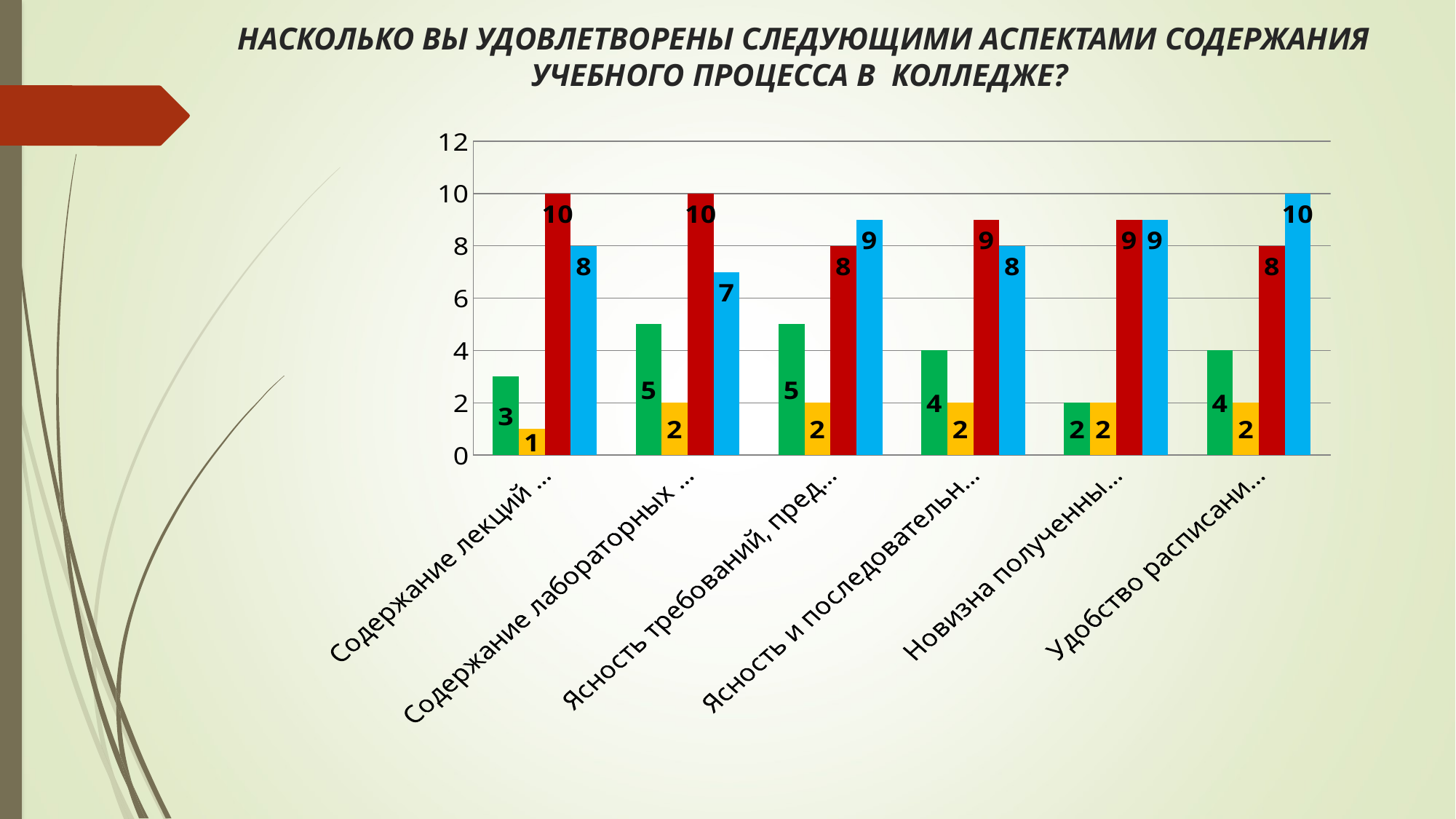
What is the value of the green bar for the category "Ясность требований, пред..."? 5 What is the value of the blue bar for the category "Содержание лабораторных ..."? 7 Which category has the highest green bar? Содержание лабораторных ... and Ясность требований, пред... (both 5) What is the value of the red bar for the category "Содержание лекций ..."? 10 What is the value of the blue bar for the category "Удобство расписани..."? 10 What kind of chart is shown on the slide? bar chart How many categories are shown on the x axis of the chart? 6 For the category "Ясность требований, пред...", which is larger, the red bar or the blue bar? the blue bar What is the value of the yellow bar for the category "Содержание лекций ..."? 1 What is the difference between the red bar and the green bar for the category "Содержание лекций ..."? 7 Which category has the lowest yellow bar? Содержание лекций ... How many differently coloured bar series are plotted for each category? 4